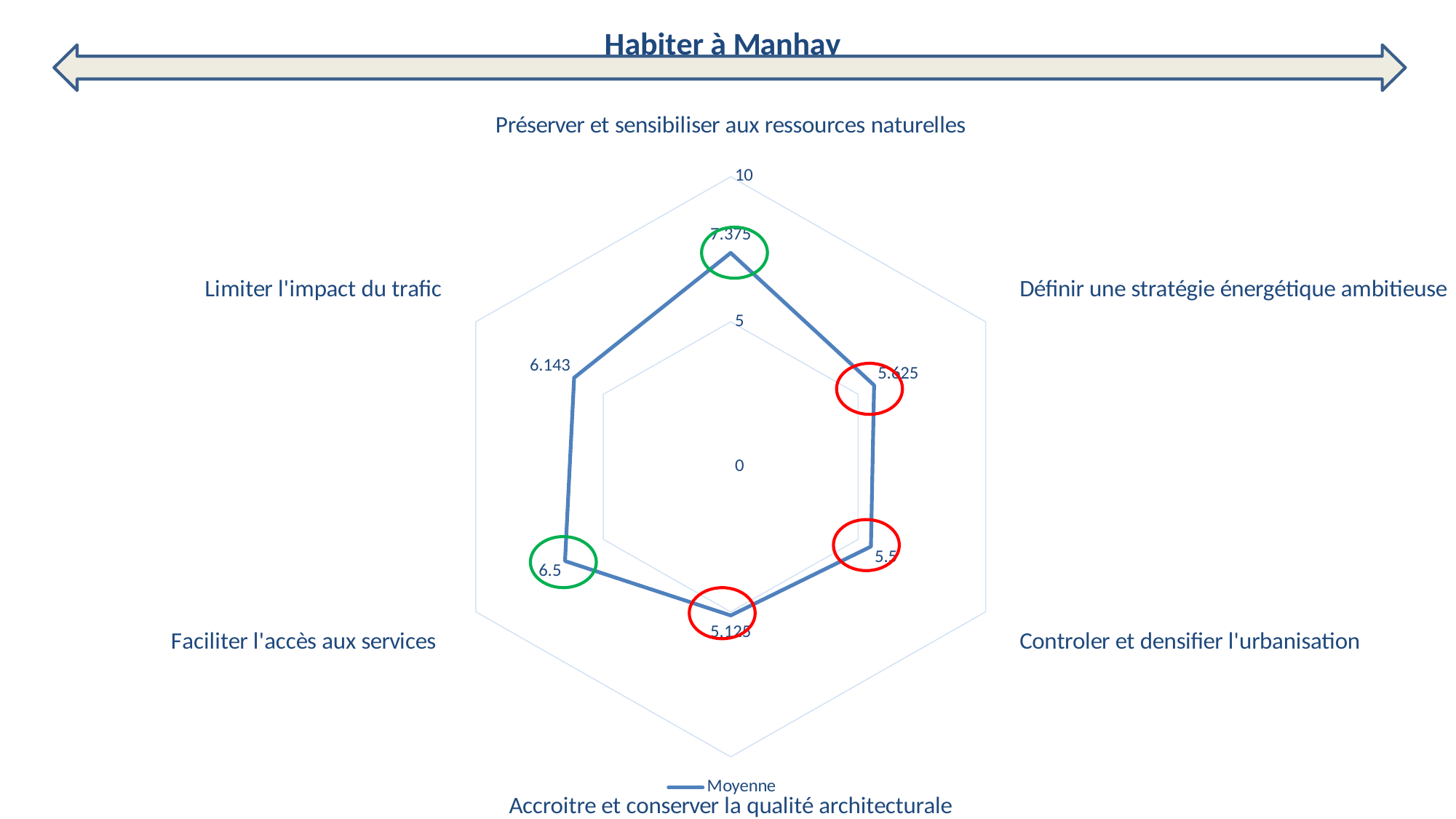
How many categories are plotted on the radar chart? 6 What is the name of the series shown in the legend? Moyenne How many series does the legend list? 1 What type of chart is shown on the slide? Radar chart What is the value for 'Accroitre et conserver la qualité architecturale'? 5.125 Which category has the highest value? Préserver et sensibiliser aux ressources naturelles What is the value for 'Définir une stratégie énergétique ambitieuse'? 5.625 What is the difference between the values for 'Faciliter l'accès aux services' and 'Controler et densifier l'urbanisation'? 1 What is the value for 'Limiter l'impact du trafic'? 6.143 Which category has the lowest value? Accroitre et conserver la qualité architecturale Which is larger, the value for 'Faciliter l'accès aux services' or the value for 'Limiter l'impact du trafic'? Faciliter l'accès aux services What is the value for 'Préserver et sensibiliser aux ressources naturelles'? 7.375